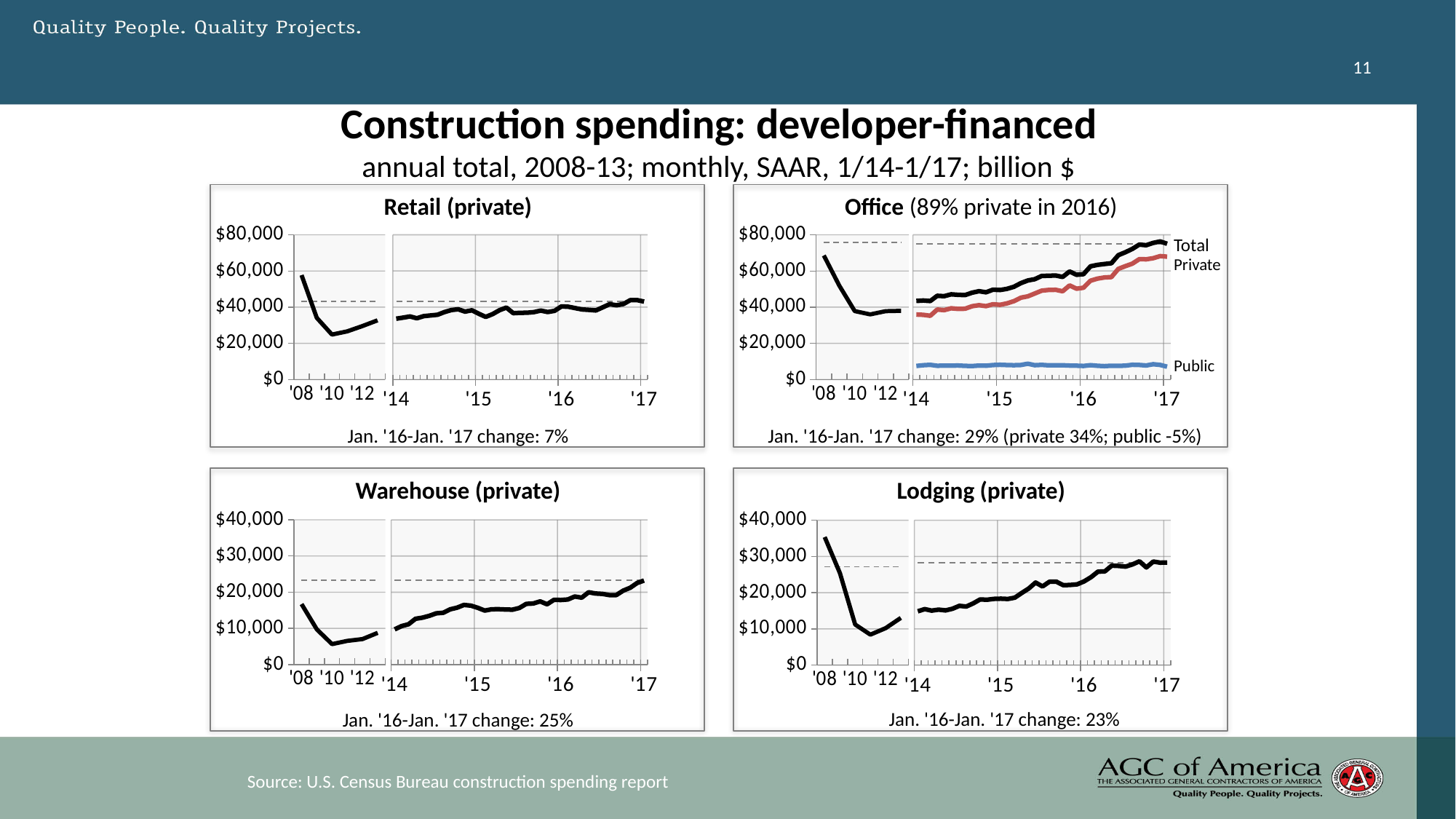
In the Warehouse (private) chart, is the value for 2008 greater or less than $10,000? greater In the Lodging (private) chart, is the value for 2008 greater or less than $30,000? greater In the Warehouse (private) chart, do the monthly values generally rise or fall from 2014 to 2017? rise In the Office chart, which series is larger in January 2017, Total or Public? Total What is the Jan. '16-Jan. '17 change shown on the Warehouse (private) chart? 25% What kind of chart is the Retail (private) chart? line chart In the Office chart, is the Public series greater or less than $20,000 throughout 2014-2017? less According to the Office chart title, what share of office spending was private in 2016? 89% In the Lodging (private) chart, do the annual values rise or fall from 2008 to 2010? fall How many series does the Office chart show? 3